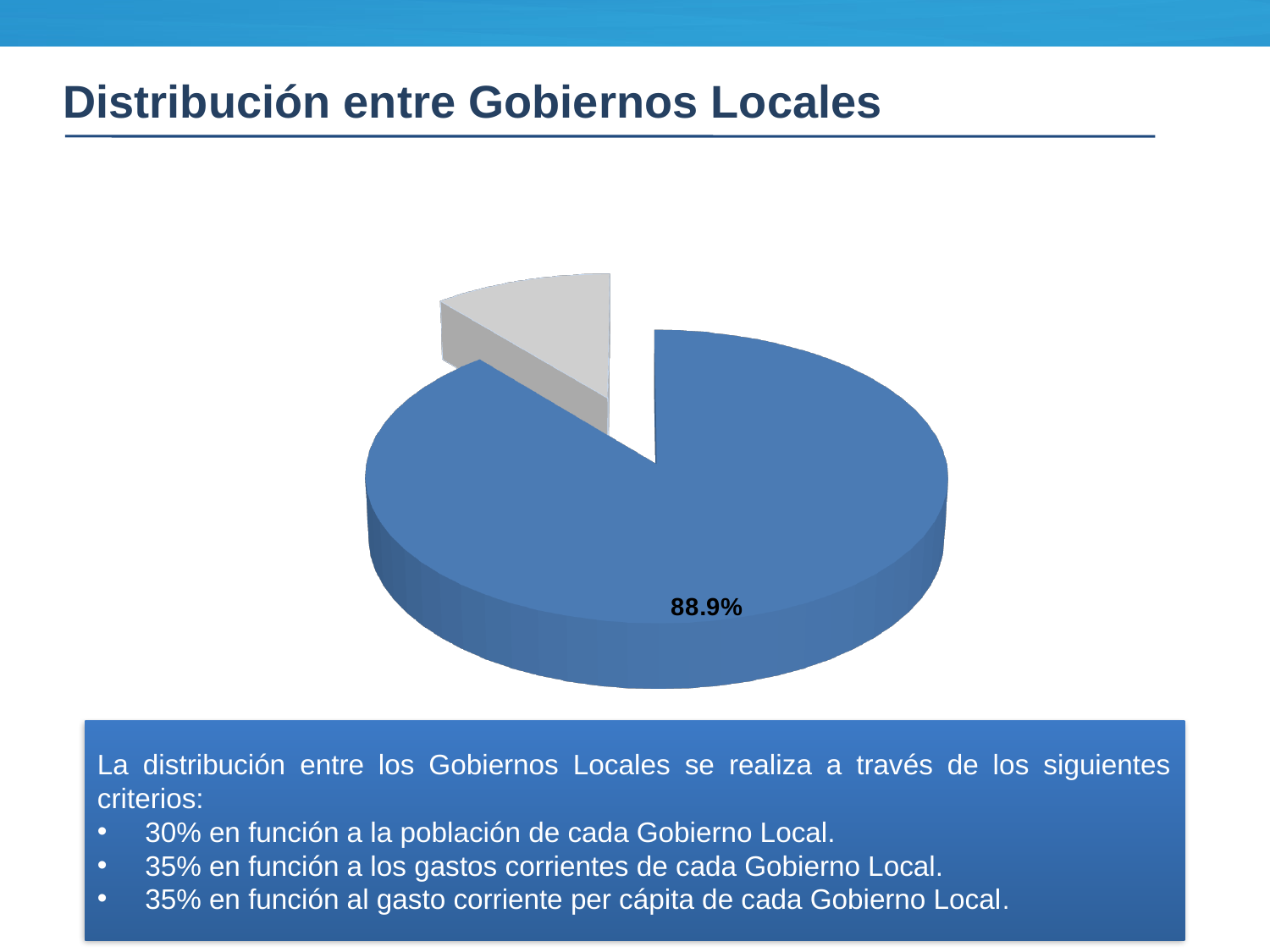
What share of the pie does the blue slice represent? 88.9% What colour is the slice that is pulled out from the rest of the pie? Grey How many slices of the pie chart have a data label printed on them? 1 Is the blue slice larger or smaller than the grey slice? Larger What value is printed on the blue slice of the pie chart? 88.9% What kind of chart is shown on the slide? Pie chart How many slices does the pie chart have? 2 Which slice of the pie chart is the largest, the blue one or the grey one? The blue one Which slice of the pie chart is the smallest, the blue one or the grey one? The grey one